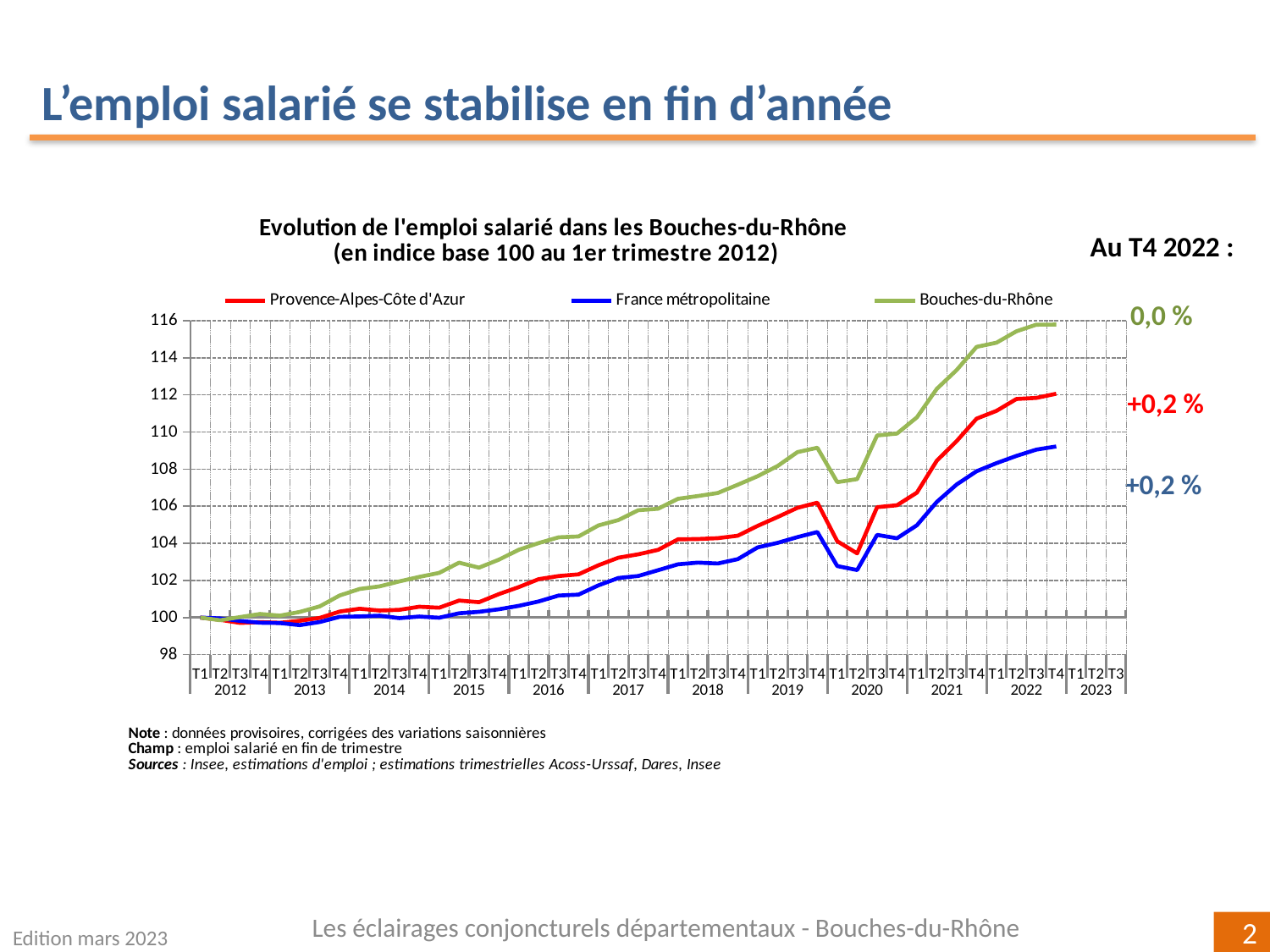
Is the value for Provence-Alpes-Côte d'Azur at T4 2022 greater or less than 110? greater What change is annotated for Bouches-du-Rhône at T4 2022 on the right of the chart? 0,0 % Which series has the highest value at T4 2022? Bouches-du-Rhône Is the value for Bouches-du-Rhône at T4 2022 greater or less than 114? greater Which series has the lowest value at T4 2022? France métropolitaine How many series does the legend of the chart list? 3 Is the value for France métropolitaine at T4 2022 greater or less than 110? less At T2 2020, which is higher: Bouches-du-Rhône or France métropolitaine? Bouches-du-Rhône Which series are listed in the chart's legend? Provence-Alpes-Côte d'Azur, France métropolitaine, Bouches-du-Rhône What is the index value of all three series at T1 2012? 100 Over the whole period from 2012 to 2022, do the index values generally rise or fall? rise What kind of chart is shown on the slide? line chart